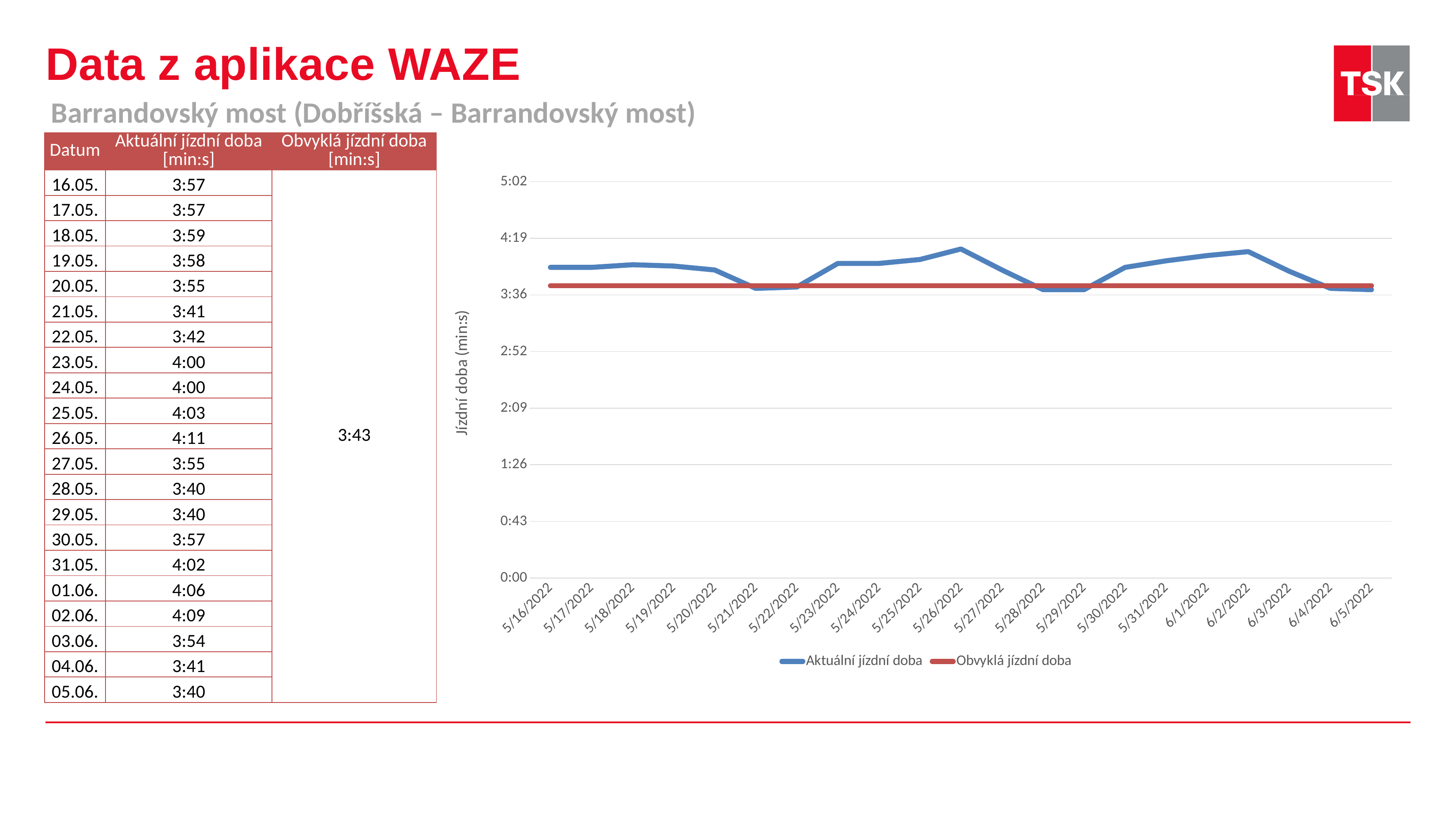
Which is larger, the Aktuální jízdní doba on 5/26/2022 or on 5/21/2022? 5/26/2022 What kind of chart is shown on the slide? line chart What is the Aktuální jízdní doba value for 5/26/2022? 4:11 Is the Aktuální jízdní doba value for 5/26/2022 greater or less than 3:36? greater How many dates are plotted along the x axis of the chart? 21 What is the value of the Obvyklá jízdní doba line? 3:43 How many series does the chart legend list? 2 Is the Aktuální jízdní doba value for 5/21/2022 greater or less than 4:19? less On which date does the Aktuální jízdní doba line reach its highest value? 5/26/2022 What is the Aktuální jízdní doba value for 6/2/2022? 4:09 What is the title of the chart's vertical axis? Jízdní doba (min:s) Does the Aktuální jízdní doba line rise or fall from 6/2/2022 to 6/5/2022? fall